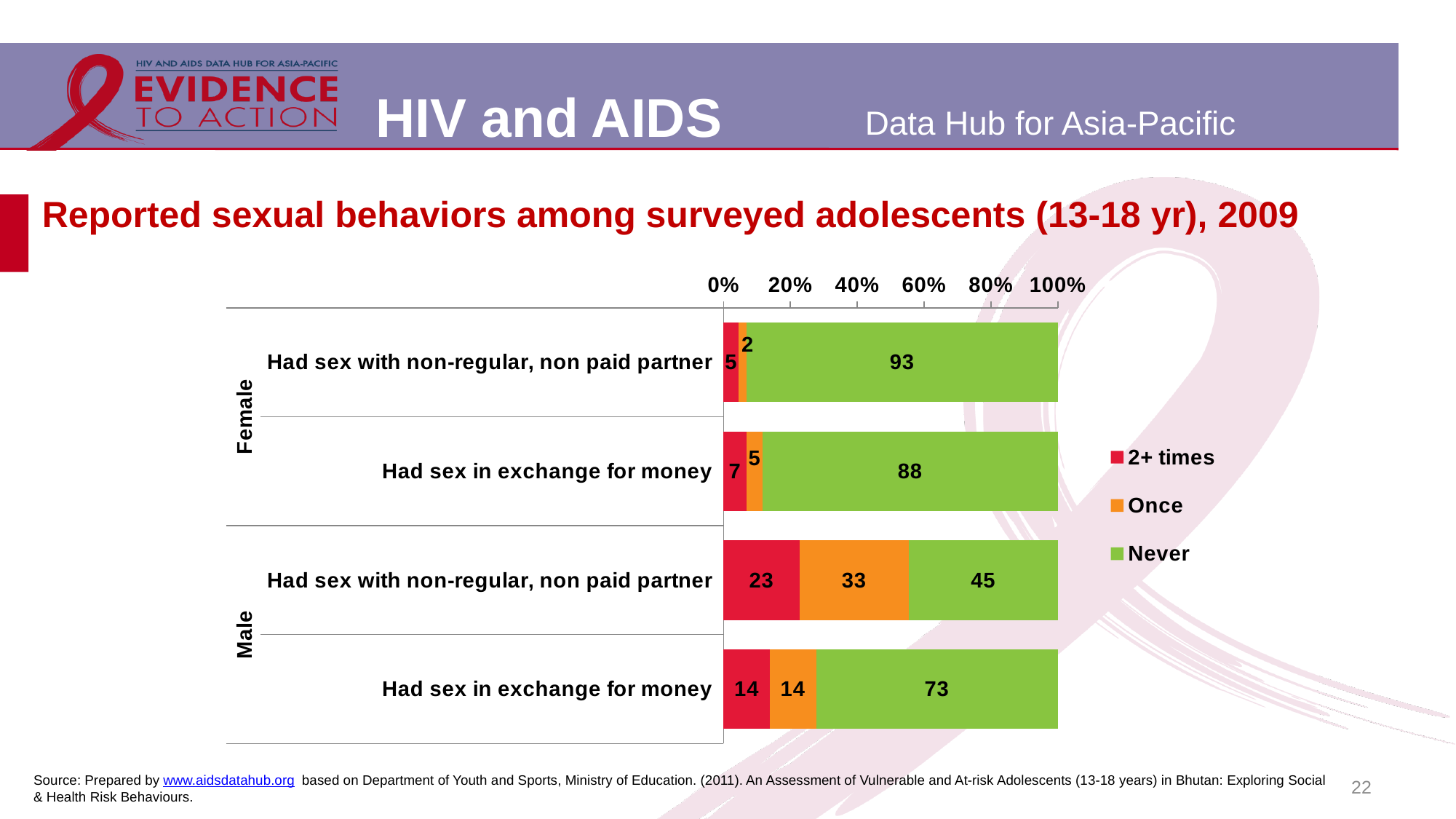
How many series does the legend list? 3 Which bar has the highest '2+ times' value? Male, Had sex with non-regular, non paid partner How many bars (category rows) are plotted in the chart? 4 What is the 'Once' value for males who had sex in exchange for money? 14 Which is larger: the 'Once' value for males who had sex with a non-regular, non paid partner, or the 'Once' value for males who had sex in exchange for money? Males who had sex with a non-regular, non paid partner (33) What are the three series listed in the legend? 2+ times, Once, Never What is the '2+ times' value for females who had sex in exchange for money? 7 Which bar has the lowest 'Never' value? Male, Had sex with non-regular, non paid partner What is the 'Never' value for males who had sex with a non-regular, non paid partner? 45 What is the difference between the 'Never' values for females and males who had sex in exchange for money? 15 What kind of chart is shown on the slide? Stacked bar chart What is the 'Never' value for females who had sex with a non-regular, non paid partner? 93